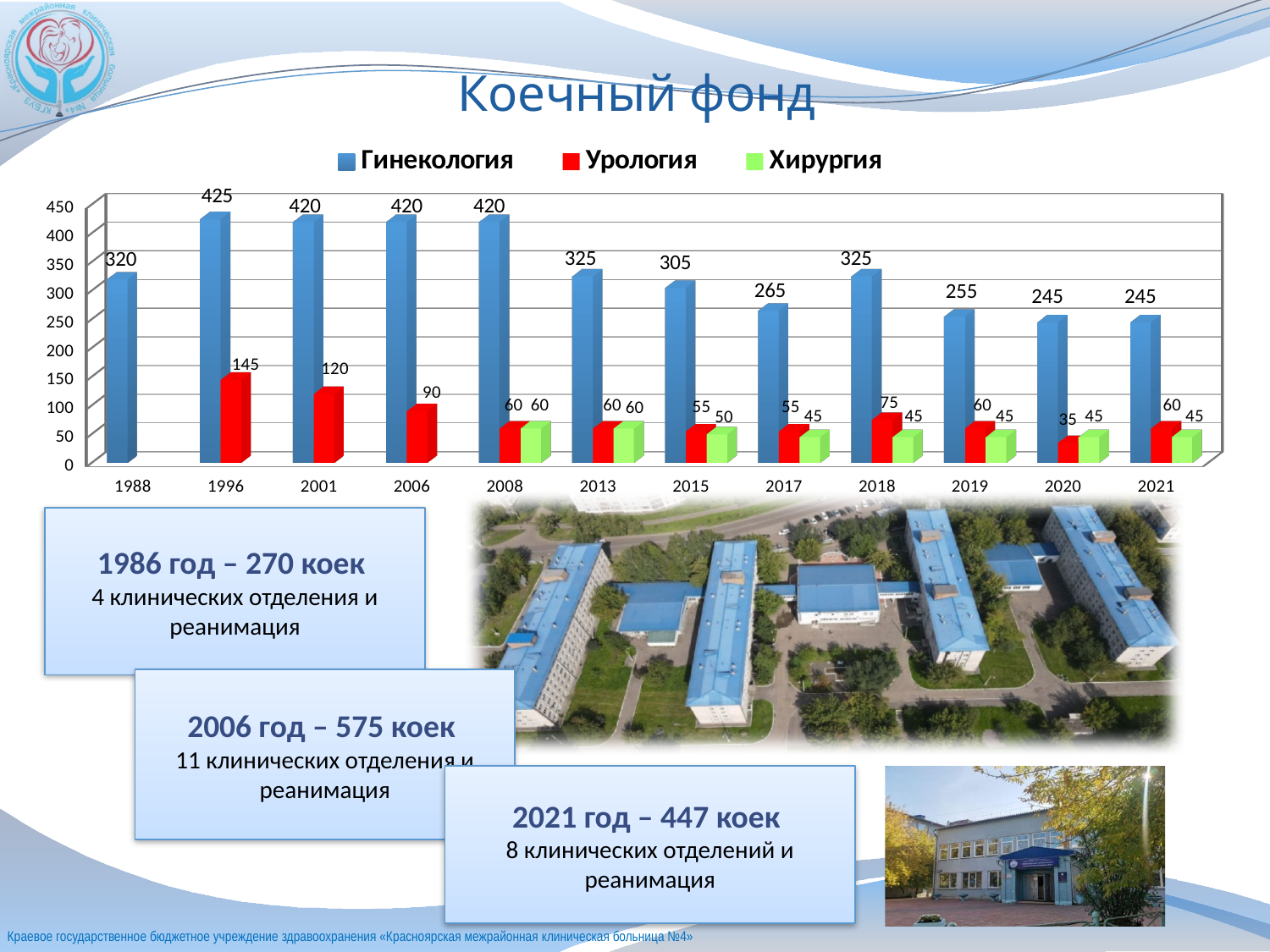
What is the value for Урология in 2020? 35 Does the Гинекология value generally rise or fall from 2008 to 2021? fall What is the title of the chart? Коечный фонд What is the value for Хирургия in 2015? 50 What is the difference between the Гинекология values in 1996 and 2021? 180 What is the value for Гинекология in 1996? 425 Which is larger: the Урология value in 2018 or the Урология value in 2019? 2018 How many series does the chart legend list? 3 What type of chart is shown on the slide? bar chart In which year is the Урология value lowest? 2020 In which year is the Гинекология value highest? 1996 How many years (categories) are shown on the x axis of the chart? 12